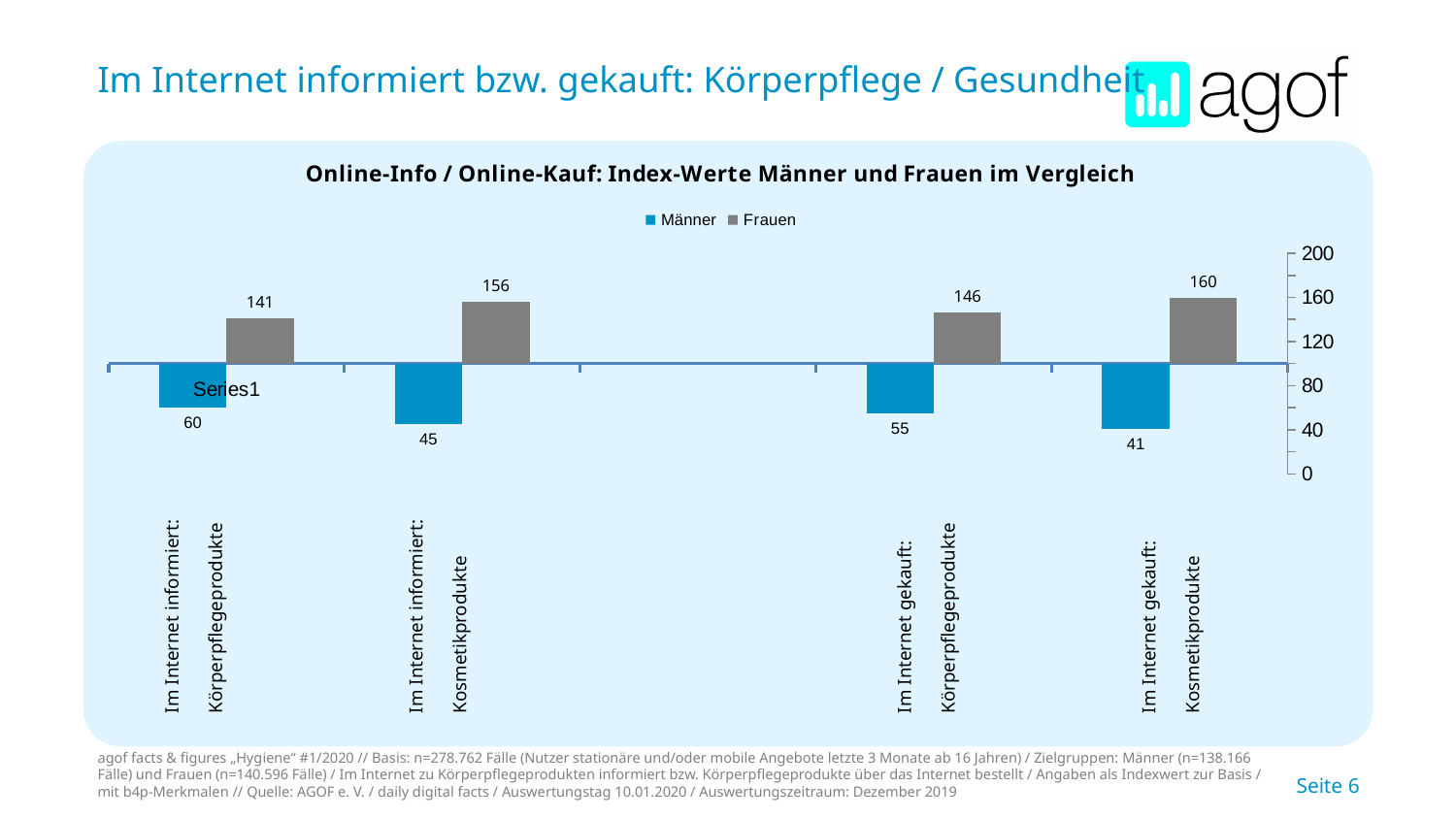
What is the Männer value for "Im Internet informiert: Körperpflegeprodukte"? 60 What is the title of the chart? Online-Info / Online-Kauf: Index-Werte Männer und Frauen im Vergleich Which category has the lowest Männer value? Im Internet gekauft: Kosmetikprodukte How many series does the legend list? 2 Which is larger: the Männer value for "Im Internet informiert: Kosmetikprodukte" or the Männer value for "Im Internet gekauft: Körperpflegeprodukte"? Im Internet gekauft: Körperpflegeprodukte Which category has the highest Frauen value? Im Internet gekauft: Kosmetikprodukte What kind of chart is shown? bar chart What is the Frauen value for "Im Internet informiert: Kosmetikprodukte"? 156 What is the Frauen value for "Im Internet gekauft: Kosmetikprodukte"? 160 What is the difference between the Frauen and Männer values for "Im Internet informiert: Körperpflegeprodukte"? 81 What is the Männer value for "Im Internet gekauft: Körperpflegeprodukte"? 55 How many categories are shown on the x axis? 4